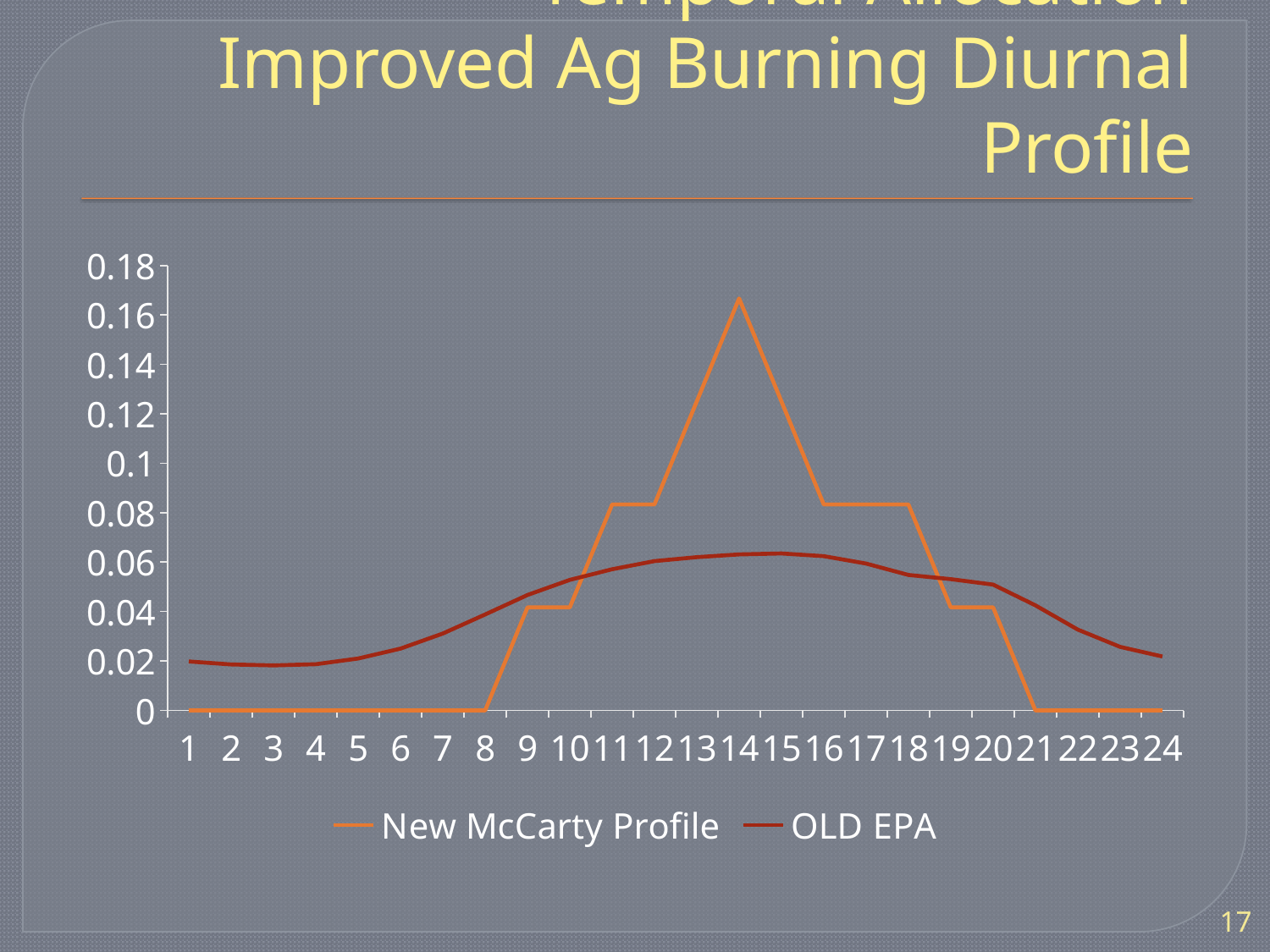
At hour 14, which series has the larger value, New McCarty Profile or OLD EPA? New McCarty Profile Is the value of OLD EPA at hour 14 greater or less than 0.08? less At hour 5, which series has the larger value, New McCarty Profile or OLD EPA? OLD EPA Is the value of the New McCarty Profile at hour 14 greater or less than 0.14? greater What kind of chart is shown on the slide? line chart What is the value of the New McCarty Profile at hour 23? 0 Does the New McCarty Profile rise or fall from hour 14 to hour 21? fall At which hour does the New McCarty Profile reach its highest value? 14 How many points are plotted along the x axis for each series? 24 Is the value of OLD EPA at hour 24 greater or less than 0.04? less What is the value of the New McCarty Profile at hour 5? 0 How many series does the legend list? 2